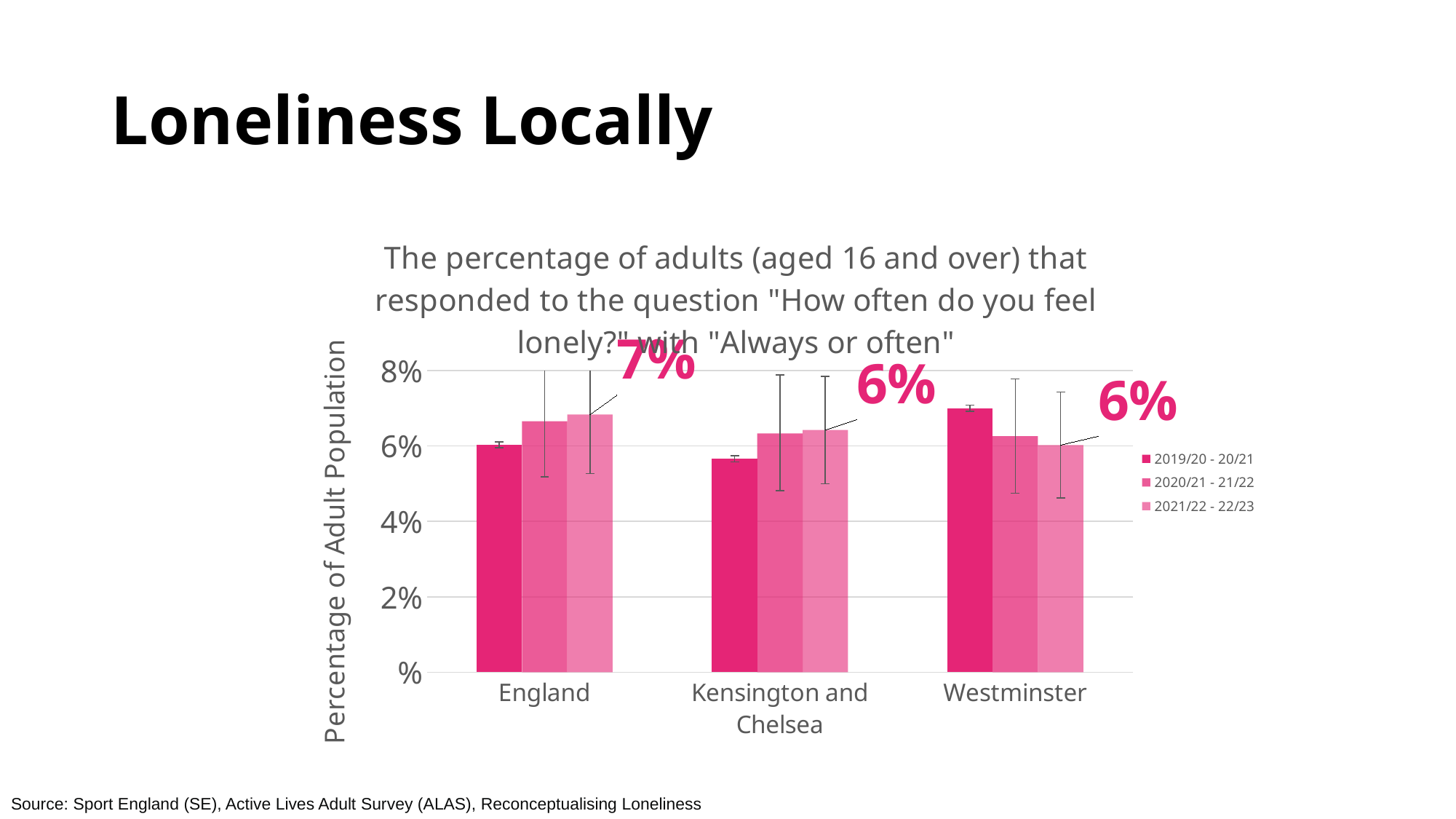
In the 2019/20 - 20/21 series, which area has the highest value? Westminster How many series does the chart's legend list? 3 In the 2019/20 - 20/21 series, which area has the lowest value? Kensington and Chelsea Is the value for Westminster in the 2019/20 - 20/21 series greater or less than 6%? greater What is the labelled value for England in the 2021/22 - 22/23 series? 7% What is the title of the chart's vertical axis? Percentage of Adult Population What kind of chart is shown on the slide? Bar chart What is the labelled value for Westminster in the 2021/22 - 22/23 series? 6% Is the value for Kensington and Chelsea in the 2019/20 - 20/21 series greater or less than 6%? less Do the values for Westminster rise or fall across the three survey periods from 2019/20 - 20/21 to 2021/22 - 22/23? Fall What is the labelled value for Kensington and Chelsea in the 2021/22 - 22/23 series? 6% How many areas (categories) are shown on the x axis of the chart? 3